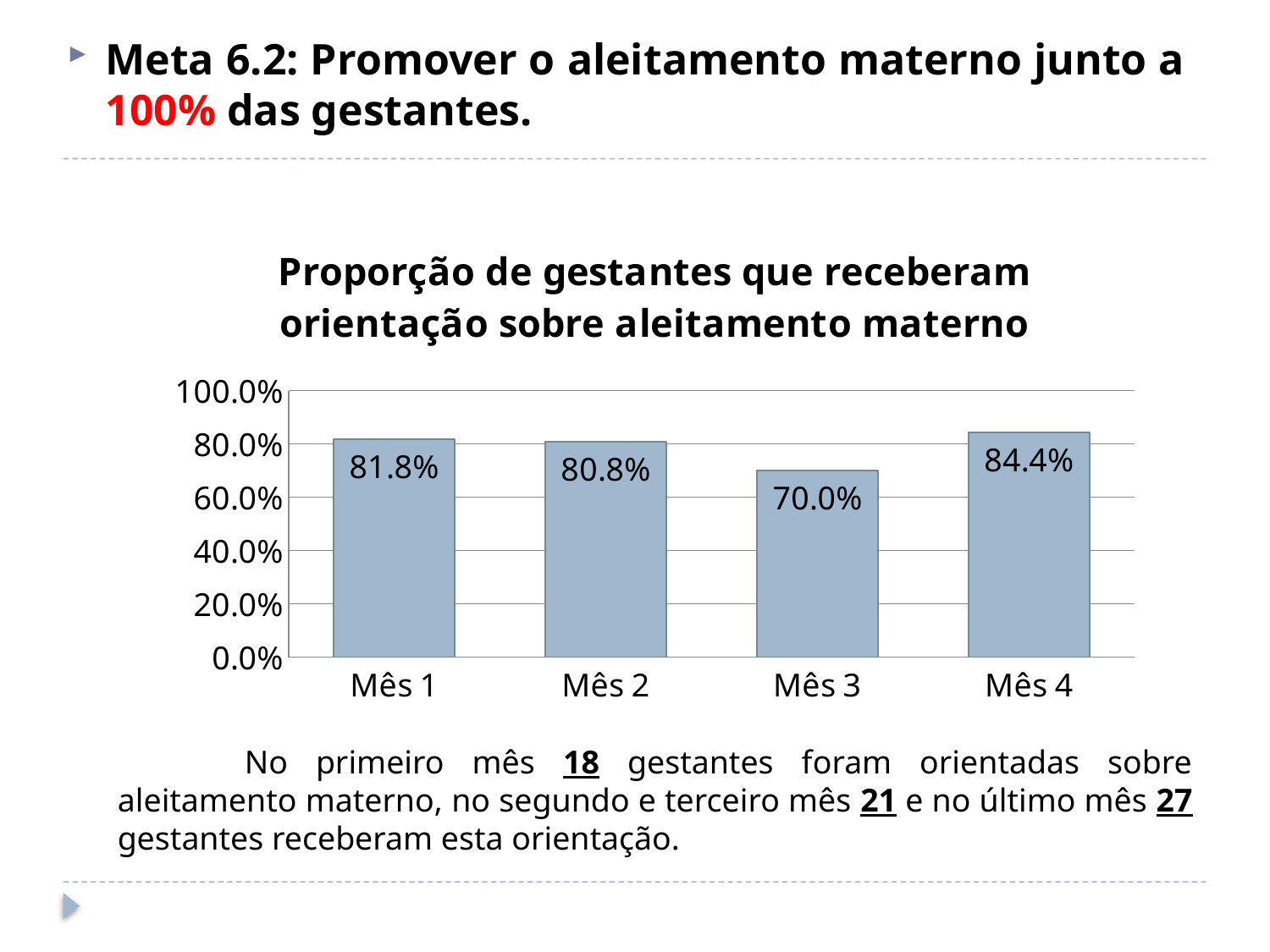
What is the difference between the values for Mês 4 and Mês 3? 14.4% Which month has the highest proportion? Mês 4 What is the value for Mês 1? 81.8% What is the difference between the values for Mês 1 and Mês 2? 1.0% Is the value for Mês 3 greater or less than 80.0%? less Which is larger, the value for Mês 2 or the value for Mês 3? Mês 2 Which month has the lowest proportion? Mês 3 What is the value for Mês 4? 84.4% What kind of chart is shown on the slide? bar chart What is the title of the chart? Proporção de gestantes que receberam orientação sobre aleitamento materno What is the value for Mês 3? 70.0% How many months are shown on the x axis? 4